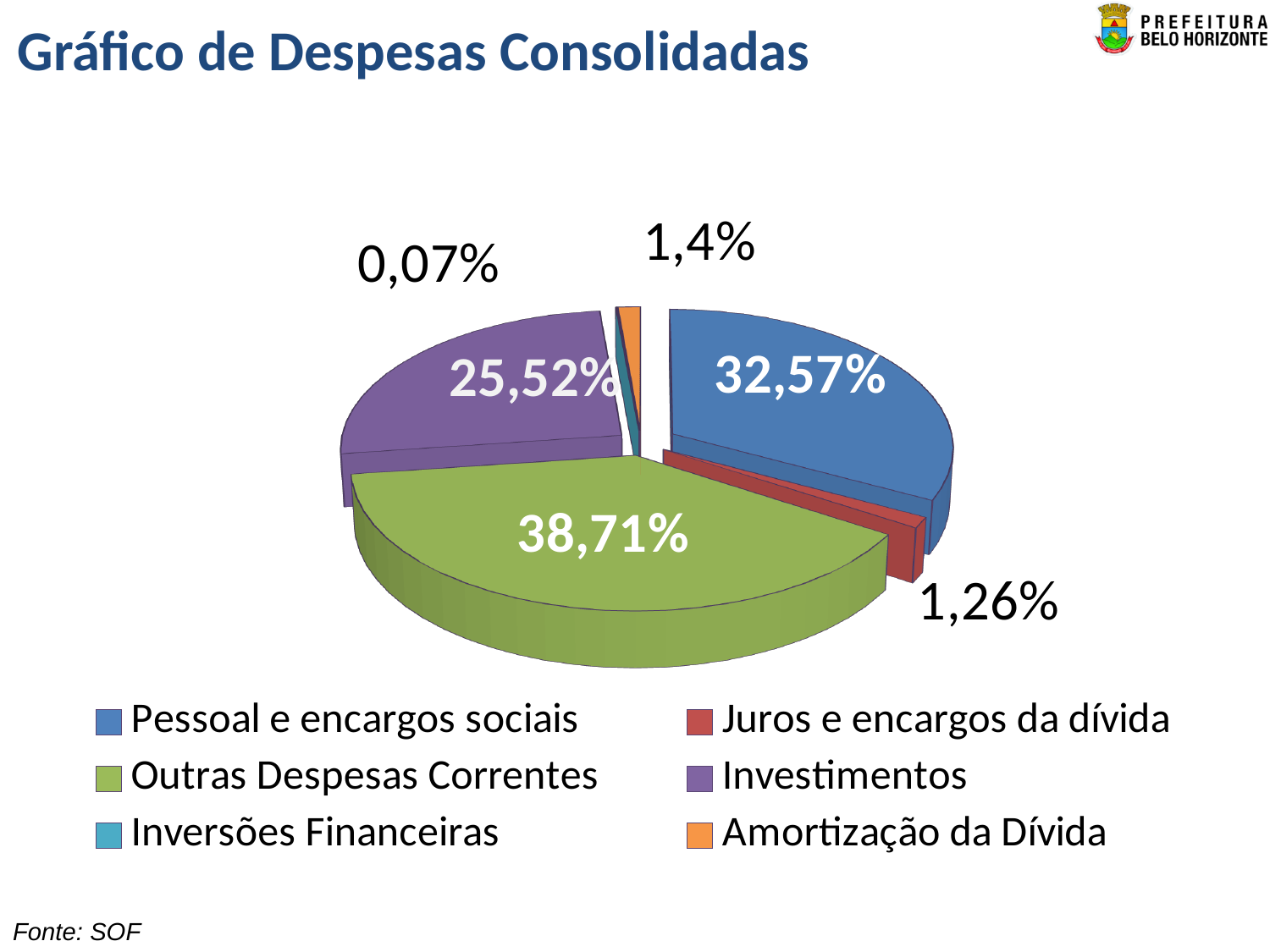
What share of the pie does Juros e encargos da dívida represent? 1,26% What share of the pie does Pessoal e encargos sociais represent? 32,57% What share of the pie does Outras Despesas Correntes represent? 38,71% What is the title of the chart on the slide? Gráfico de Despesas Consolidadas What share of the pie does Amortização da Dívida represent? 1,4% Which category has the largest slice of the pie? Outras Despesas Correntes Which is larger, the slice for Pessoal e encargos sociais or the slice for Investimentos? Pessoal e encargos sociais How many categories does the pie chart show? 6 What kind of chart is shown on the slide? Pie chart What is the difference in percentage points between Outras Despesas Correntes and Pessoal e encargos sociais? 6,14 Which category has the smallest slice of the pie? Inversões Financeiras What share of the pie does Investimentos represent? 25,52%